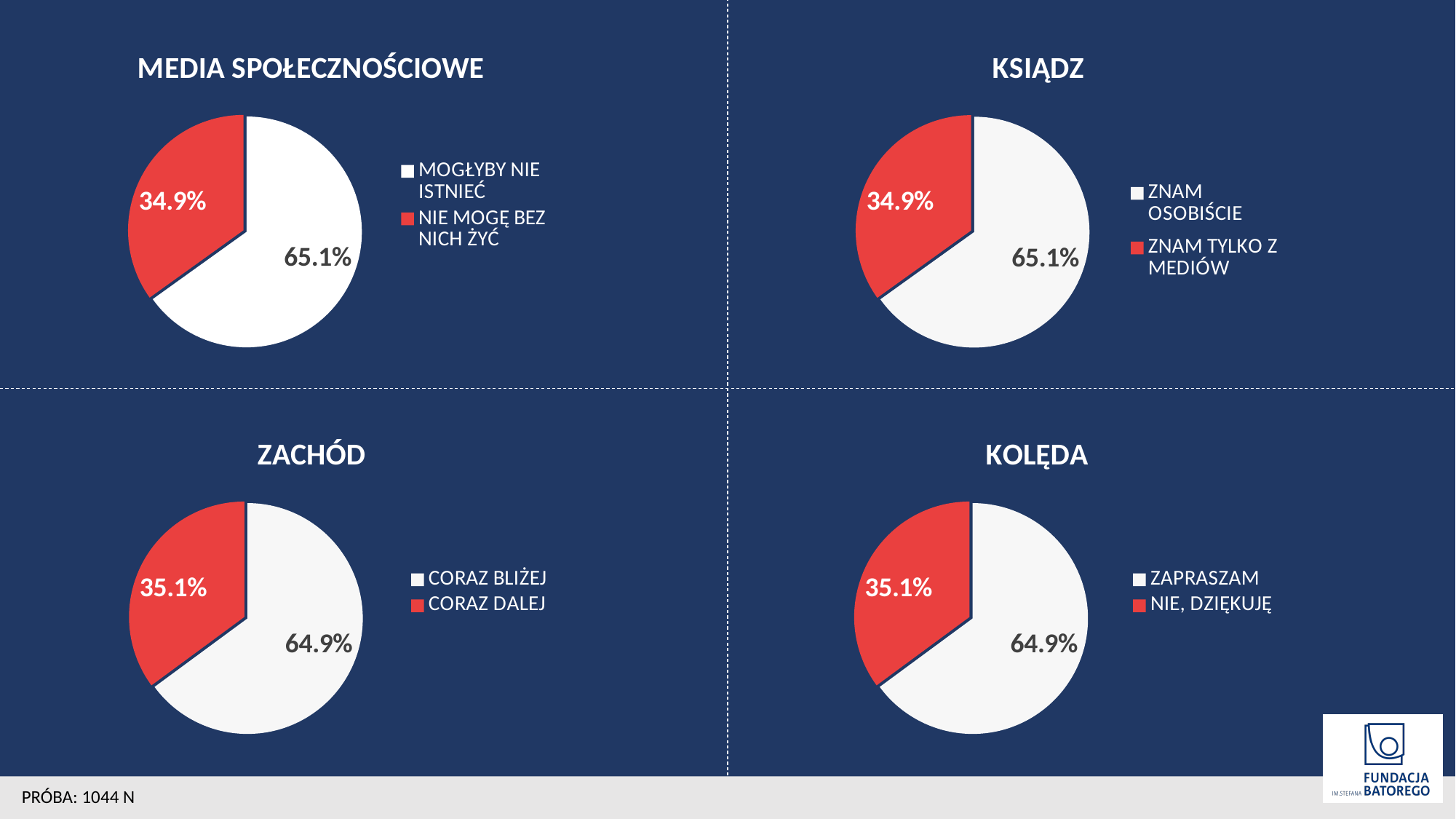
In the 'KSIĄDZ' pie chart, which is larger: 'ZNAM OSOBIŚCIE' or 'ZNAM TYLKO Z MEDIÓW'? ZNAM OSOBIŚCIE In the 'ZACHÓD' pie chart, which slice is the largest? CORAZ BLIŻEJ In the 'KSIĄDZ' pie chart, what share is labelled for 'ZNAM OSOBIŚCIE'? 65.1% In the 'KOLĘDA' pie chart, what share is labelled for 'ZAPRASZAM'? 64.9% In the 'KSIĄDZ' pie chart, what share is labelled for 'ZNAM TYLKO Z MEDIÓW'? 34.9% In the 'ZACHÓD' pie chart, what share is labelled for 'CORAZ DALEJ'? 35.1% In the 'MEDIA SPOŁECZNOŚCIOWE' pie chart, what share is labelled for 'MOGŁYBY NIE ISTNIEĆ'? 65.1% How many slices does the 'ZACHÓD' pie chart have? 2 In the 'KOLĘDA' pie chart, which slice is the smallest? NIE, DZIĘKUJĘ In the 'MEDIA SPOŁECZNOŚCIOWE' pie chart, what share is labelled for 'NIE MOGĘ BEZ NICH ŻYĆ'? 34.9% What type of chart is used for 'KOLĘDA'? Pie chart In the 'MEDIA SPOŁECZNOŚCIOWE' pie chart, what is the difference in percentage points between 'MOGŁYBY NIE ISTNIEĆ' and 'NIE MOGĘ BEZ NICH ŻYĆ'? 30.2 percentage points